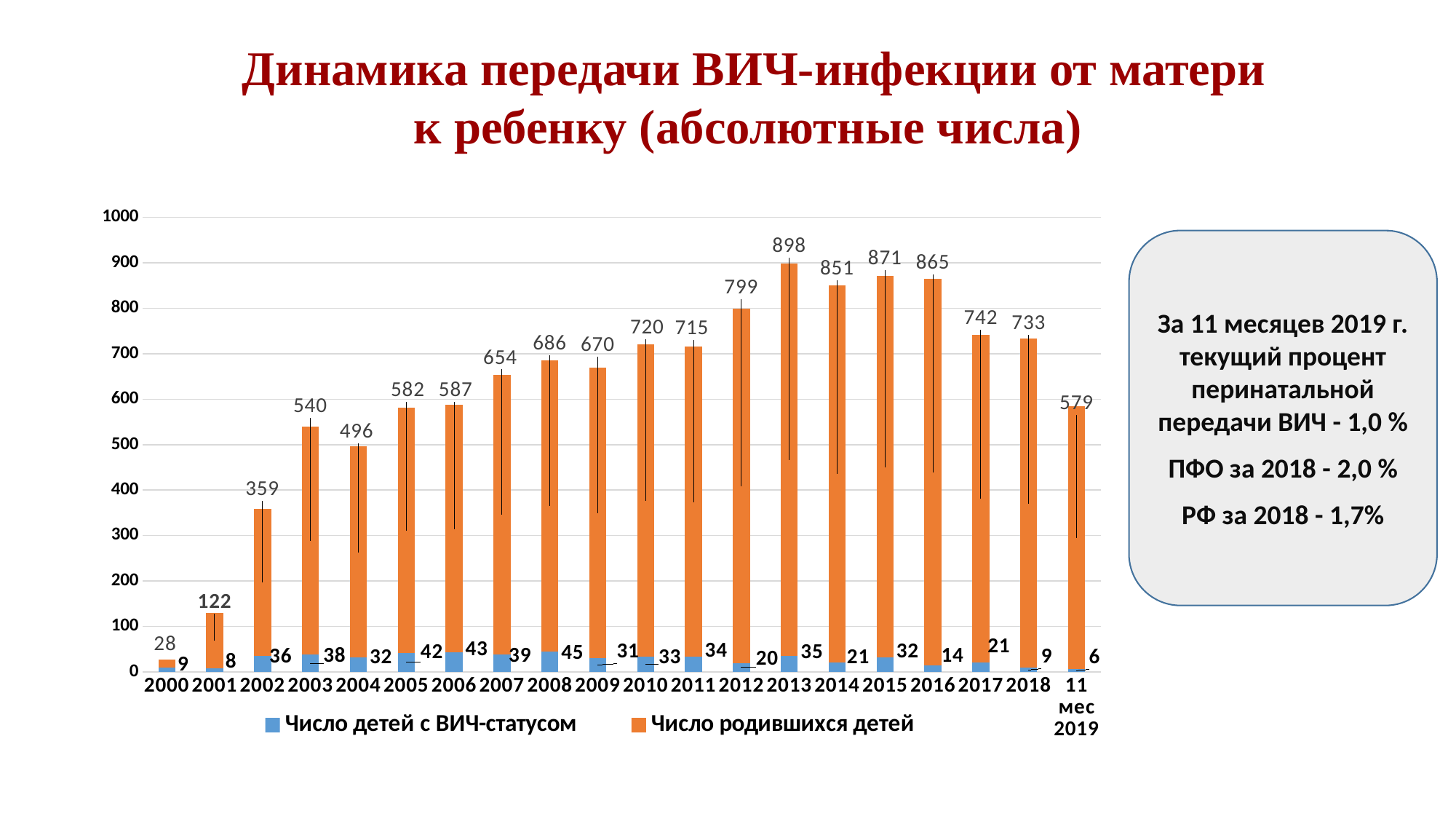
What is the value of "Число детей с ВИЧ-статусом" for 2008? 45 Which category has the lowest value for "Число детей с ВИЧ-статусом"? 11 мес 2019 How many series does the legend list? 2 What is the value of "Число родившихся детей" for 2013? 898 Which is larger, the "Число родившихся детей" value for 2015 or for 2016? 2015 What is the difference between the "Число родившихся детей" values for 2017 and 2018? 9 Is the value of "Число родившихся детей" for 2003 greater or less than 500? greater How many categories are shown on the x axis? 20 Which year has the highest value for "Число родившихся детей"? 2013 What is the value of "Число родившихся детей" for 11 мес 2019? 579 Which colour represents "Число детей с ВИЧ-статусом" in the legend? blue What kind of chart is shown on the slide? bar chart